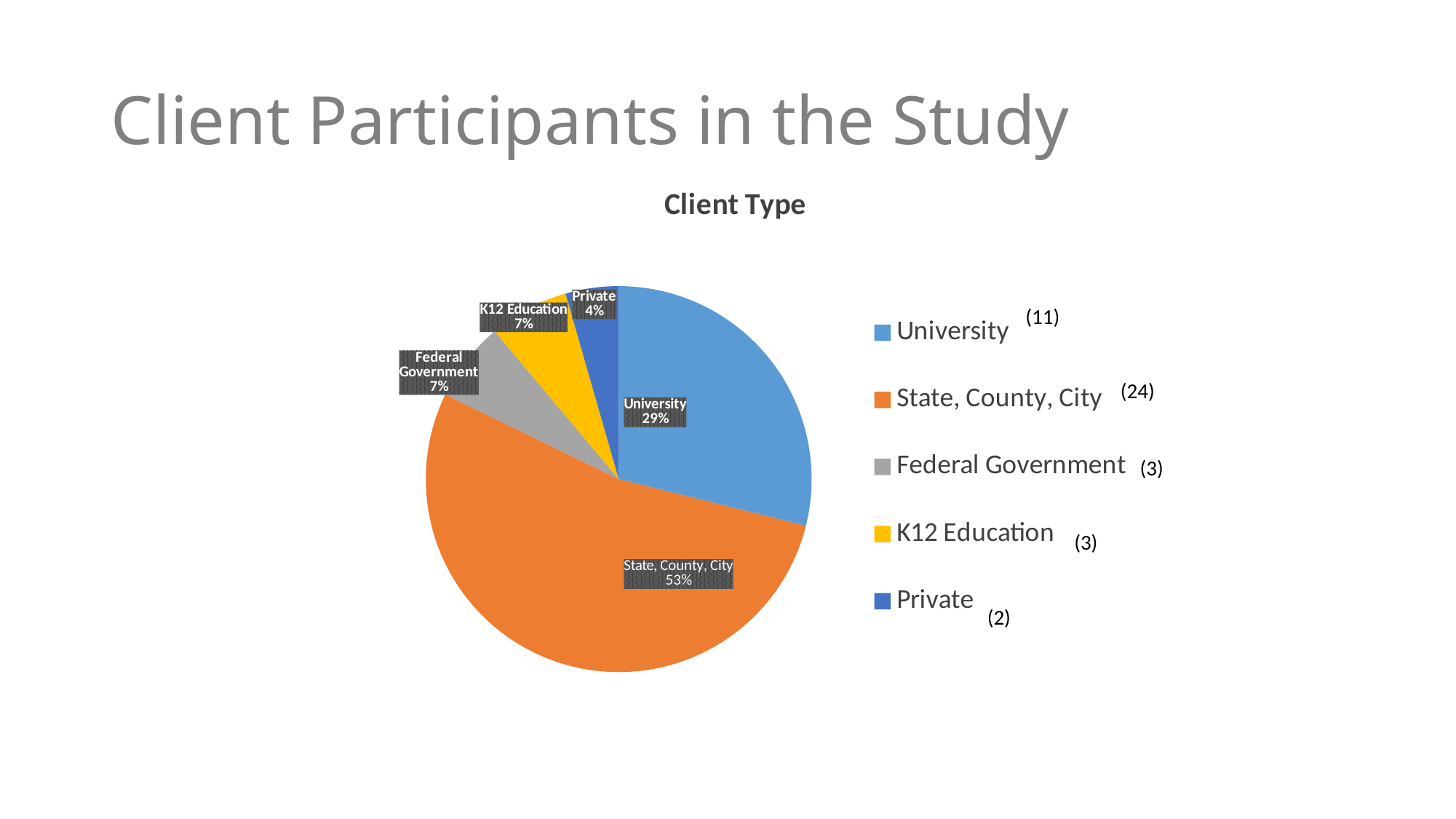
Which client type has the smallest slice of the pie? Private What is the difference in percentage points between the State, County, City slice and the University slice? 24 Which client type has the largest slice of the pie? State, County, City What percentage of the pie does Private represent? 4% What percentage of the pie does State, County, City represent? 53% Which slice is larger, University or K12 Education? University How many client types are shown in the pie chart? 5 What kind of chart is shown on the slide? pie chart What percentage of the pie does University represent? 29% What is the title of the chart? Client Type What colour is the State, County, City slice? orange